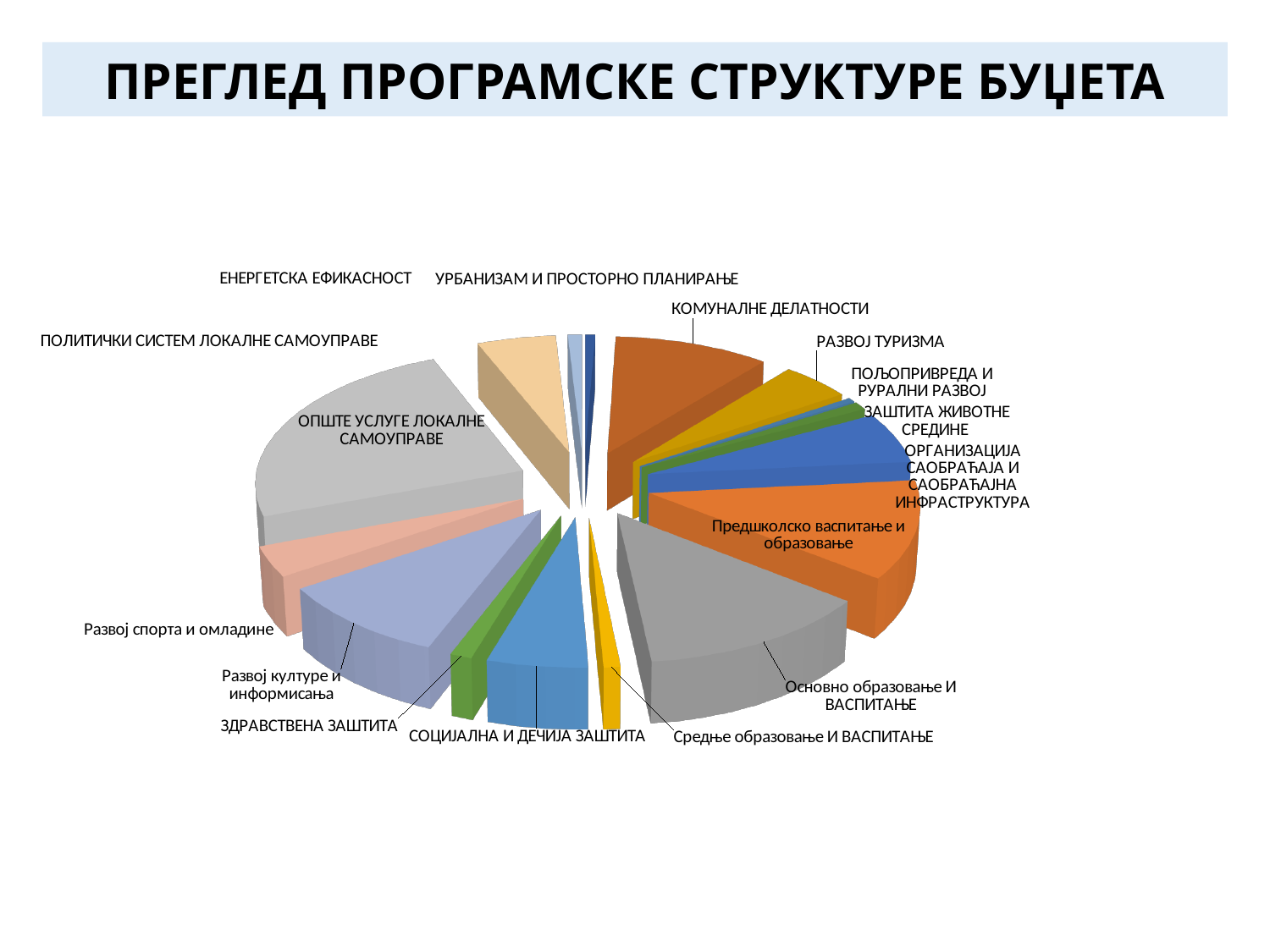
Which slice is larger: Предшколско васпитање и образовање or ПОЉОПРИВРЕДА И РУРАЛНИ РАЗВОЈ? Предшколско васпитање и образовање Which slice is larger: СОЦИЈАЛНА И ДЕЧИЈА ЗАШТИТА or УРБАНИЗАМ И ПРОСТОРНО ПЛАНИРАЊЕ? СОЦИЈАЛНА И ДЕЧИЈА ЗАШТИТА What is the title of the slide containing the pie chart? ПРЕГЛЕД ПРОГРАМСКЕ СТРУКТУРЕ БУЏЕТА How many slices (categories) does the pie chart have? 16 Which slice is larger: ОПШТЕ УСЛУГЕ ЛОКАЛНЕ САМОУПРАВЕ or ЗДРАВСТВЕНА ЗАШТИТА? ОПШТЕ УСЛУГЕ ЛОКАЛНЕ САМОУПРАВЕ Does the pie chart display numeric data labels on its slices? No What kind of chart is shown on the slide? pie chart